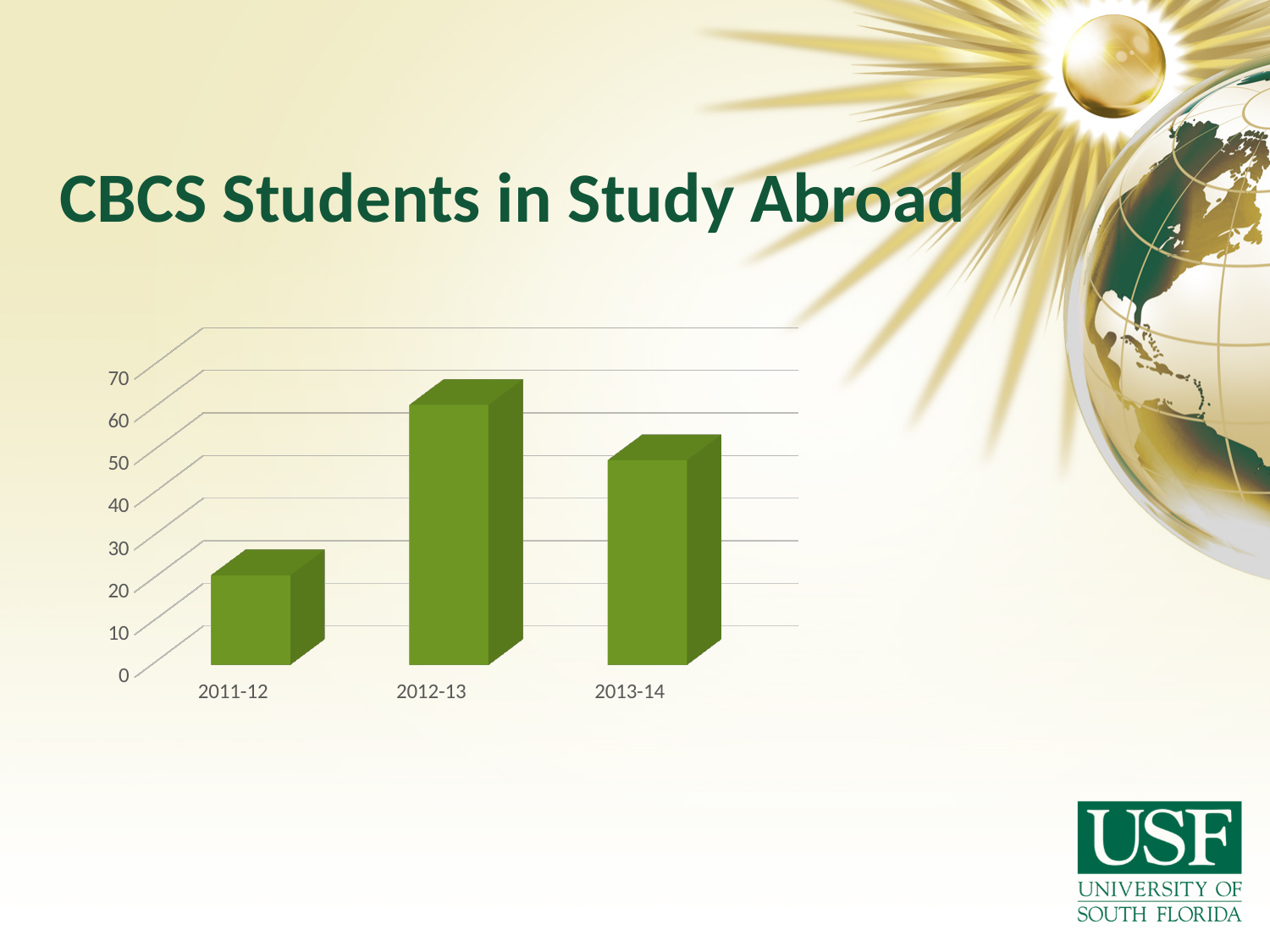
How many categories are shown on the x axis of the chart? 3 What is the title of the slide containing the chart? CBCS Students in Study Abroad What kind of chart is shown on the slide? bar chart Does the value rise or fall from 2011-12 to 2012-13? rise Which year has the highest value in the chart? 2012-13 Is the value for 2013-14 greater or less than 40? greater Is the value for 2011-12 greater or less than 30? less Which year has the lowest value in the chart? 2011-12 Is the value for 2012-13 greater or less than 50? greater Which is larger, the value for 2012-13 or the value for 2013-14? 2012-13 Which is larger, the value for 2011-12 or the value for 2013-14? 2013-14